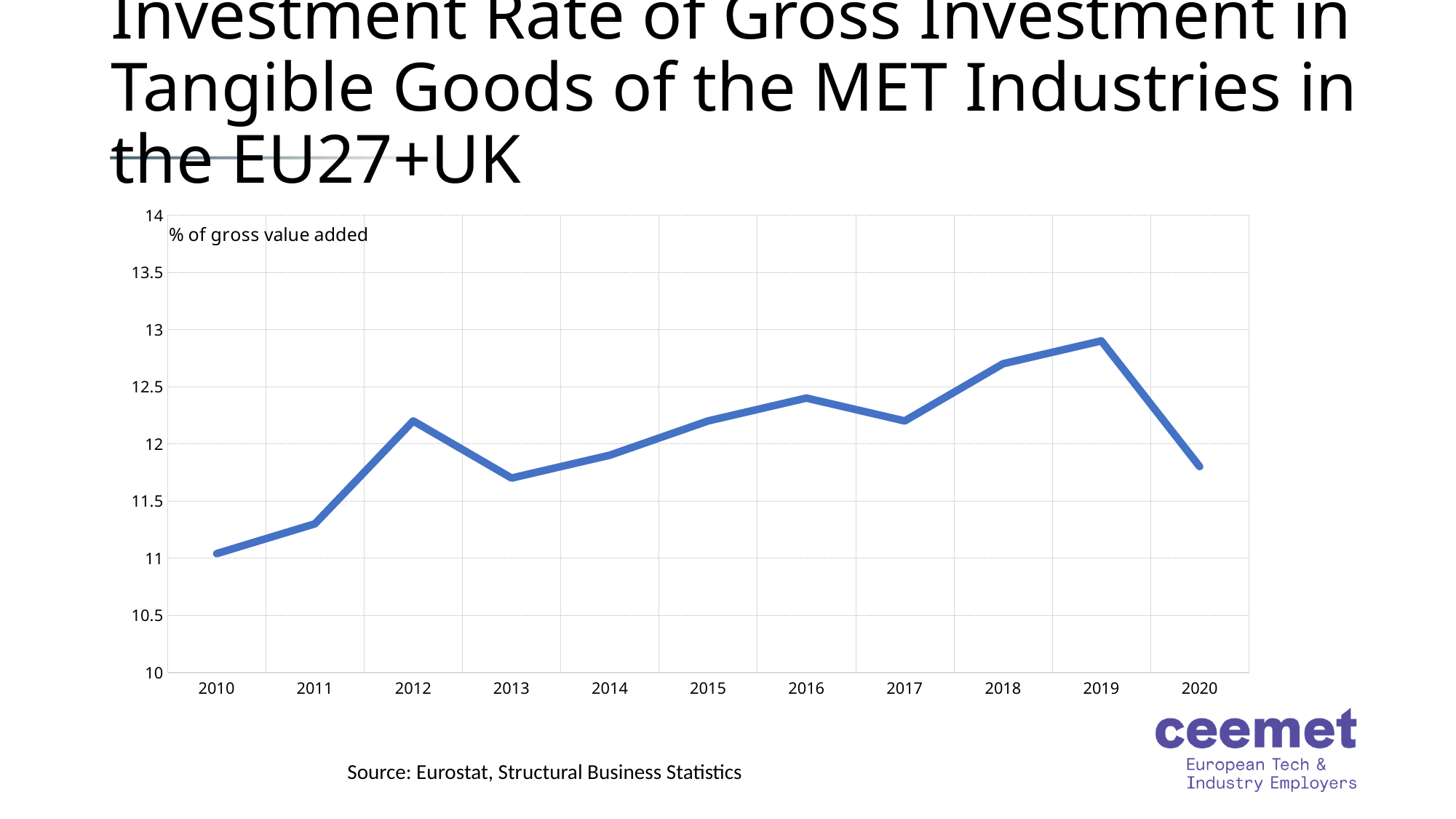
Is the value for 2020 greater or less than 12? less Which year has the larger value, 2012 or 2013? 2012 Does the investment rate rise or fall from 2019 to 2020? fall Is the value for 2019 greater or less than 12.5? greater What kind of chart is shown on the slide? line chart In what unit are the values on the chart expressed? % of gross value added How many years are plotted on the x axis? 11 In which year is the investment rate lowest? 2010 In which year is the investment rate highest? 2019 Is the value for 2013 greater or less than 12? less Which year has the larger value, 2016 or 2017? 2016